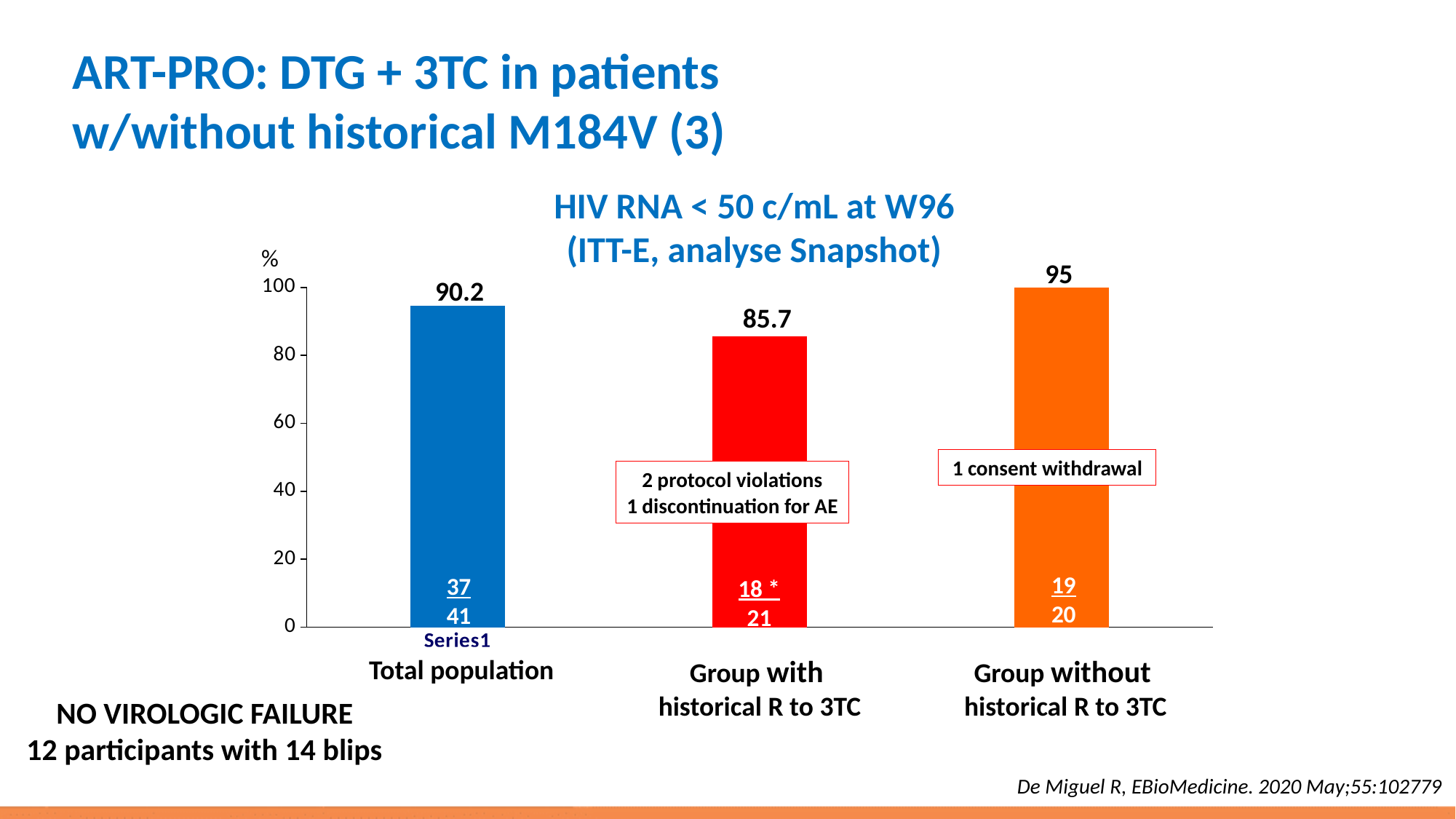
How many categories are shown in the chart? 3 What is the value for Total population? 90.2 What is the value for the Group without historical R to 3TC? 95 What is the difference between the value for the Group without historical R to 3TC and the Group with historical R to 3TC? 9.3 What is the value for the Group with historical R to 3TC? 85.7 Which is larger, the value for Total population or the value for the Group with historical R to 3TC? Total population What colour is the bar for the Group without historical R to 3TC? orange Which category has the lowest value? Group with historical R to 3TC What is the title of the chart? HIV RNA < 50 c/mL at W96 (ITT-E, analyse Snapshot) What kind of chart is shown on the slide? bar chart Which category has the highest value? Group without historical R to 3TC Is the value for the Group with historical R to 3TC greater or less than 80? greater